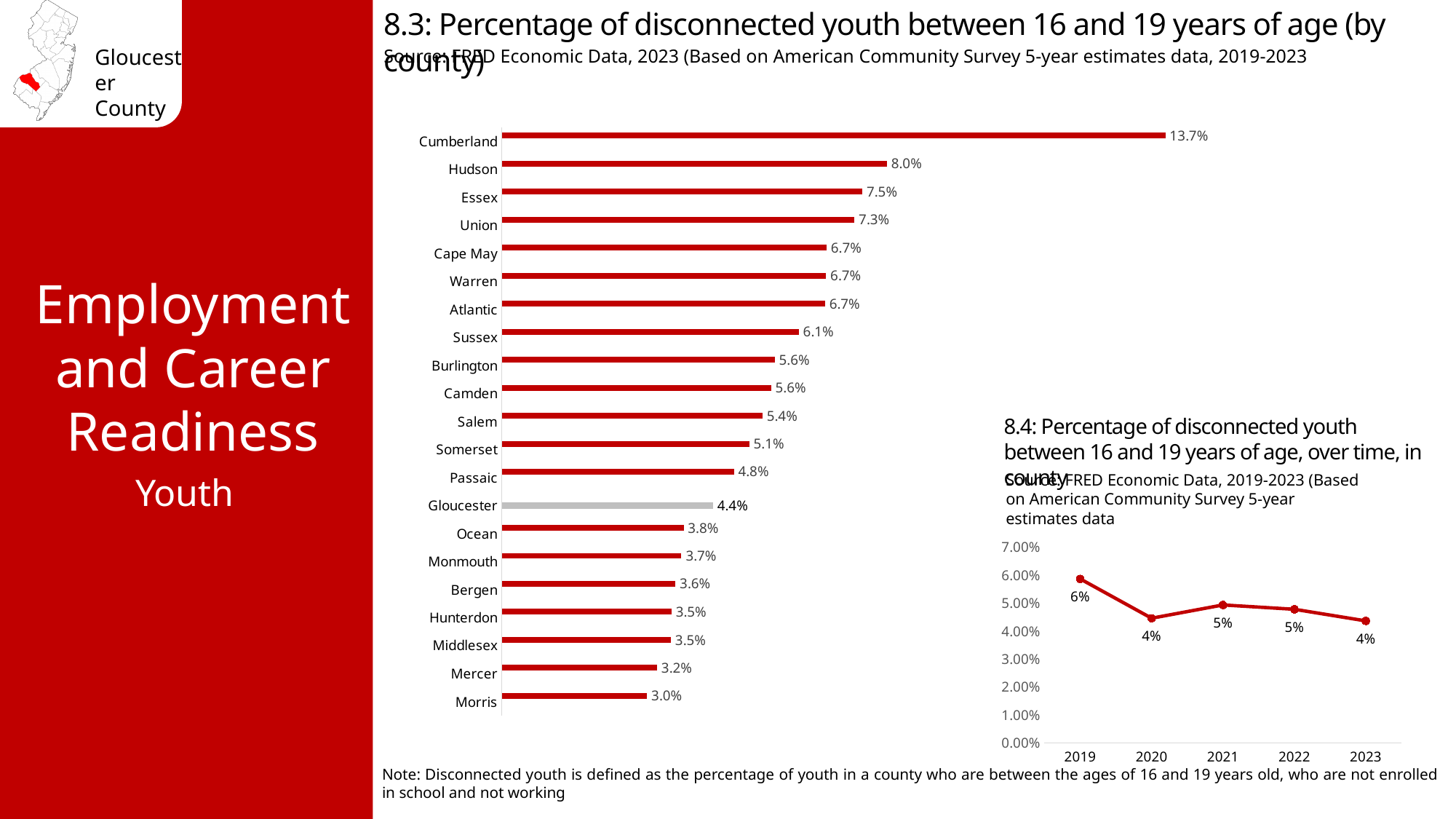
In chart 8.3, which bar is shown in a different colour (grey) from the others? Gloucester In chart 8.3, what is the difference between the values for Hudson and Gloucester? 3.6% In chart 8.3, which county has the lowest percentage of disconnected youth? Morris In chart 8.3, what is the percentage of disconnected youth for Gloucester? 4.4% In chart 8.4, what is the value for 2019? 6% How many counties are shown in chart 8.3? 21 What kind of chart is chart 8.3? Bar chart In chart 8.3, which has a higher value, Salem or Passaic? Salem In chart 8.3, what is the percentage of disconnected youth for Cumberland? 13.7% In chart 8.3, which county has the highest percentage of disconnected youth? Cumberland What kind of chart is chart 8.4? Line chart In chart 8.4, how many years are plotted? 5